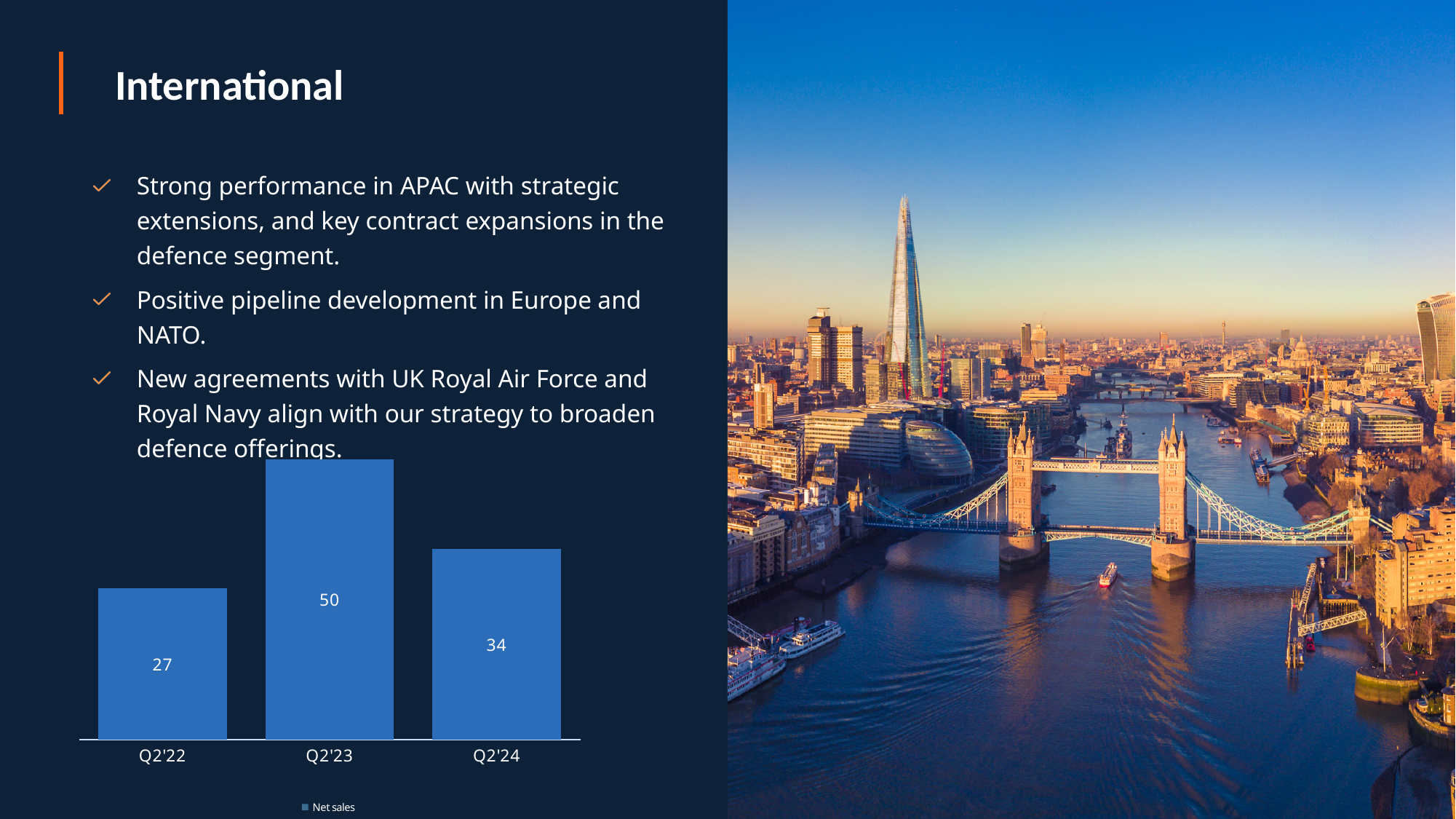
Which quarter has the highest Net sales? Q2'23 Which is larger, Net sales for Q2'24 or Q2'22? Q2'24 What is the Net sales value for Q2'23? 50 What is the difference in Net sales between Q2'23 and Q2'24? 16 What is the name of the series shown in the chart legend? Net sales What is the difference in Net sales between Q2'23 and Q2'22? 23 What kind of chart is shown on the slide? Bar chart How many quarters are shown in the chart? 3 What is the Net sales value for Q2'24? 34 How many series does the legend list? 1 Which quarter has the lowest Net sales? Q2'22 What is the Net sales value for Q2'22? 27